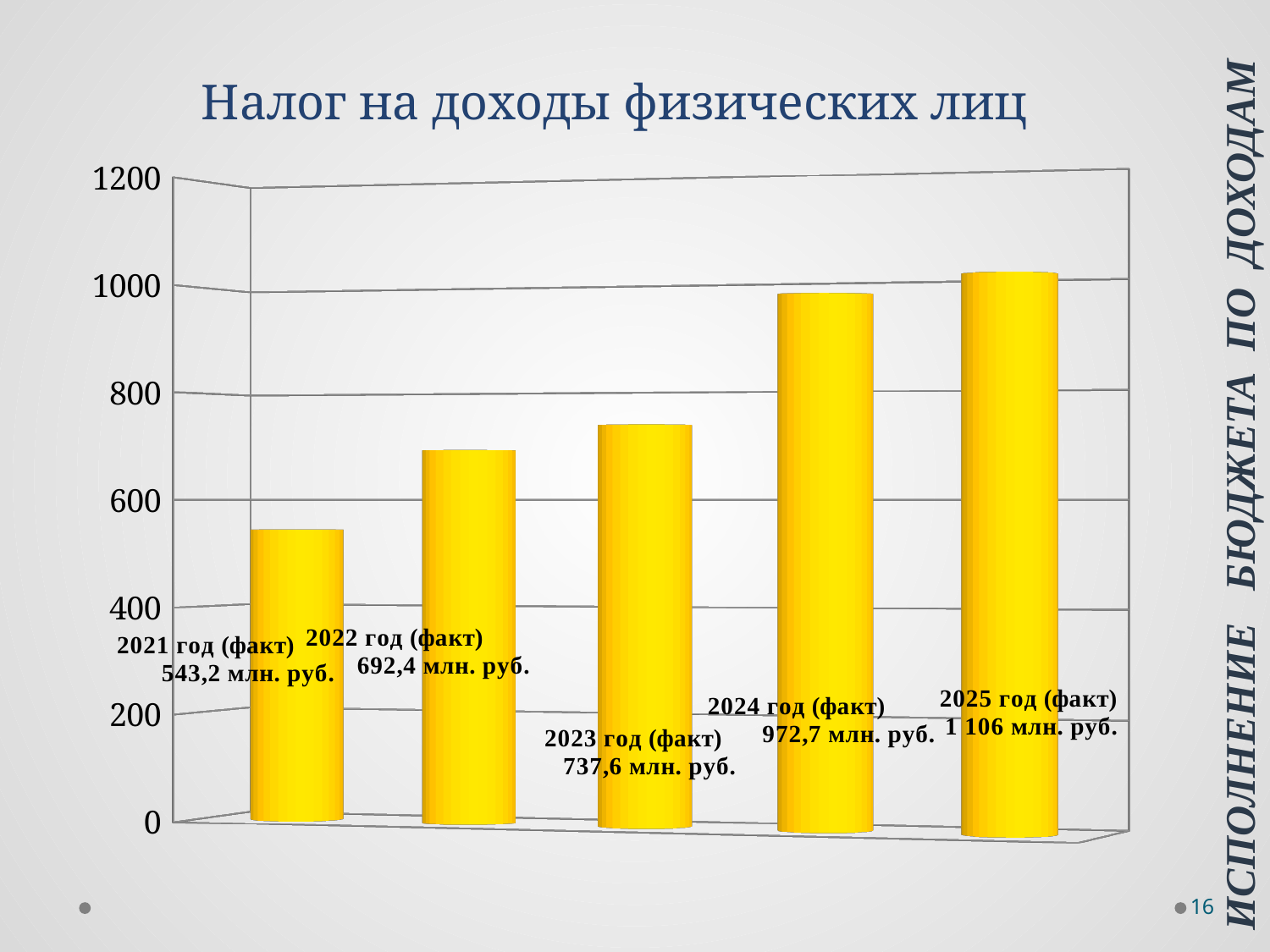
Which is larger, the value for 2023 год (факт) or 2022 год (факт)? 2023 год (факт) What is the value for 2025 год (факт)? 1 106 млн. руб. Which year has the lowest value? 2021 год (факт) How many bars are shown in the chart? 5 What is the value for 2024 год (факт)? 972,7 млн. руб. What kind of chart is shown on the slide? bar chart What is the value for 2021 год (факт)? 543,2 млн. руб. Which year has the highest value? 2025 год (факт) What is the difference between the values for 2024 год (факт) and 2023 год (факт)? 235,1 млн. руб. What is the difference between the values for 2022 год (факт) and 2021 год (факт)? 149,2 млн. руб. Is the value for 2021 год (факт) greater or less than 600? less Do the values rise or fall from 2021 to 2025? rise